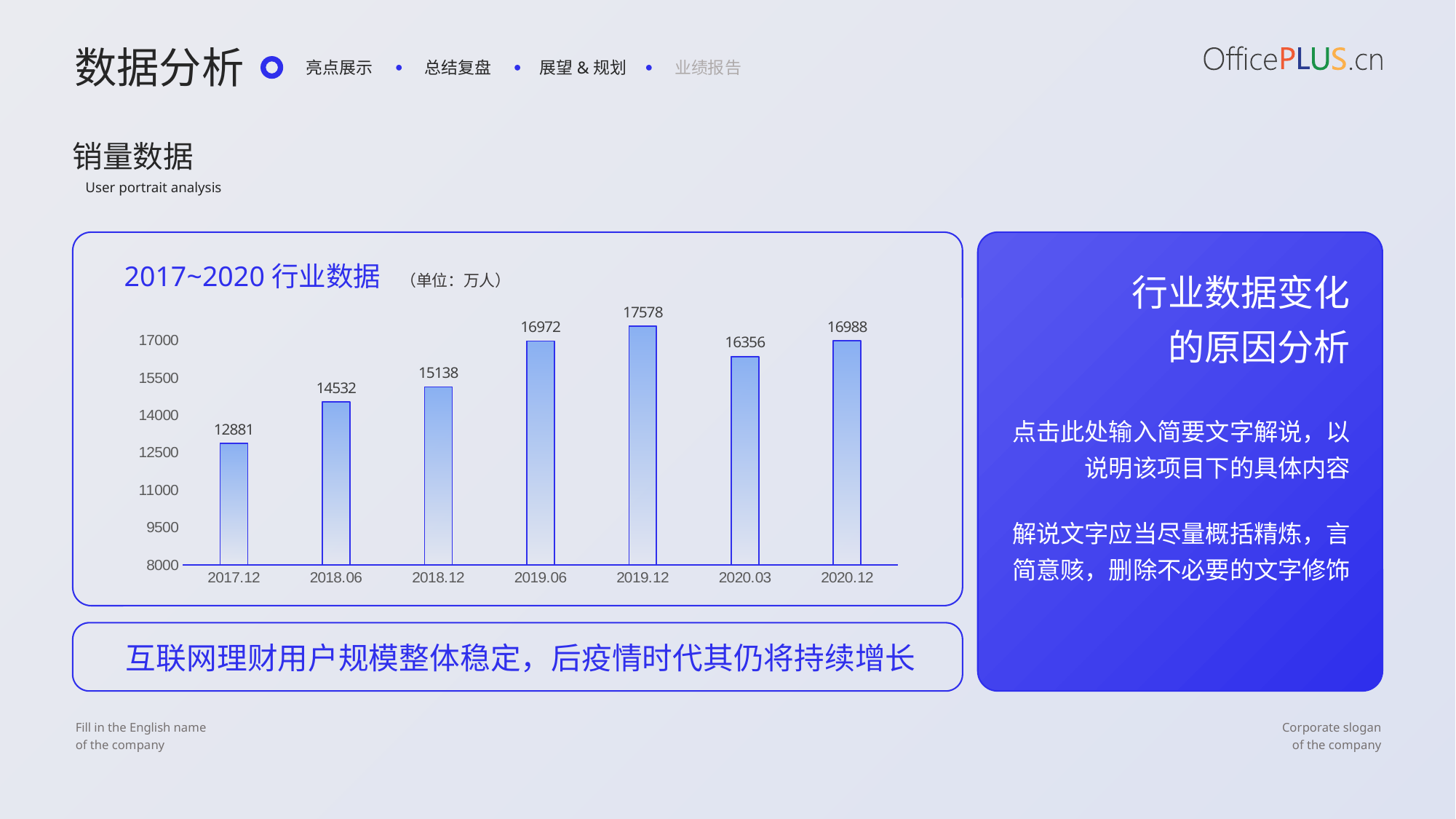
Is the value for 2018.12 greater or less than 14000? greater What is the value for 2020.03? 16356 How many periods are shown on the x axis? 7 What is the difference between the values for 2019.12 and 2020.03? 1222 Which period has the highest value? 2019.12 What is the value for 2019.06? 16972 What is the difference between the values for 2018.06 and 2017.12? 1651 What is the value for 2017.12? 12881 What unit is stated next to the chart title? 万人 What kind of chart is shown on the slide? Bar chart Which is larger, the value for 2020.12 or the value for 2020.03? 2020.12 Which period has the lowest value? 2017.12